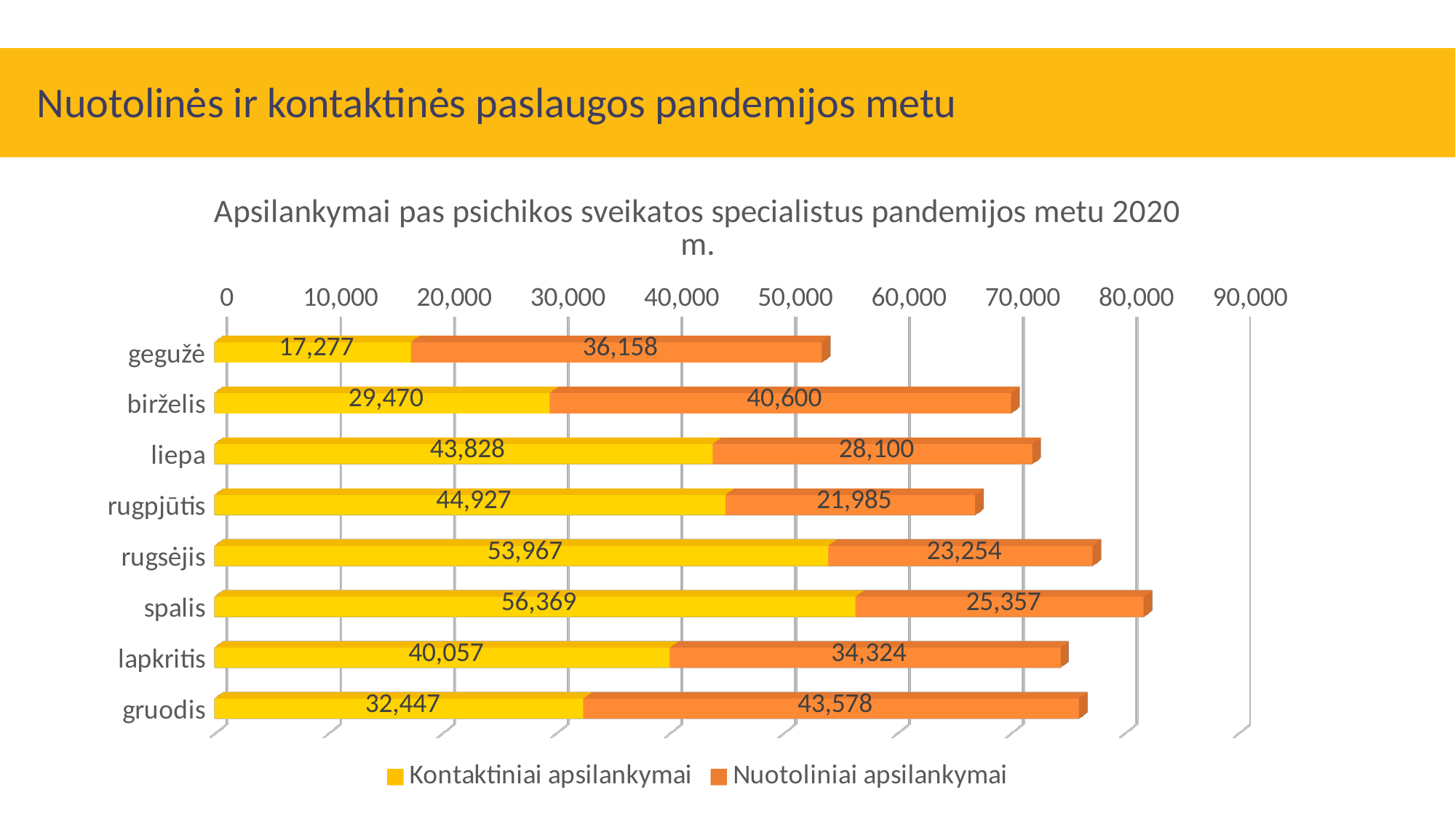
Which month has the highest value for Kontaktiniai apsilankymai? spalis Which is larger for birželis: Kontaktiniai apsilankymai or Nuotoliniai apsilankymai? Nuotoliniai apsilankymai What is the total of the stacked bar for spalis? 81,726 What is the value of Nuotoliniai apsilankymai for gegužė? 36,158 How many months are shown on the chart? 8 What kind of chart is shown on the slide? Stacked bar chart Which month has the highest value for Nuotoliniai apsilankymai? gruodis Which month has the lowest value for Nuotoliniai apsilankymai? rugpjūtis Which month has the lowest value for Kontaktiniai apsilankymai? gegužė What is the value of Nuotoliniai apsilankymai for lapkritis? 34,324 What is the value of Kontaktiniai apsilankymai for spalis? 56,369 What is the difference between Nuotoliniai apsilankymai and Kontaktiniai apsilankymai for gruodis? 11,131